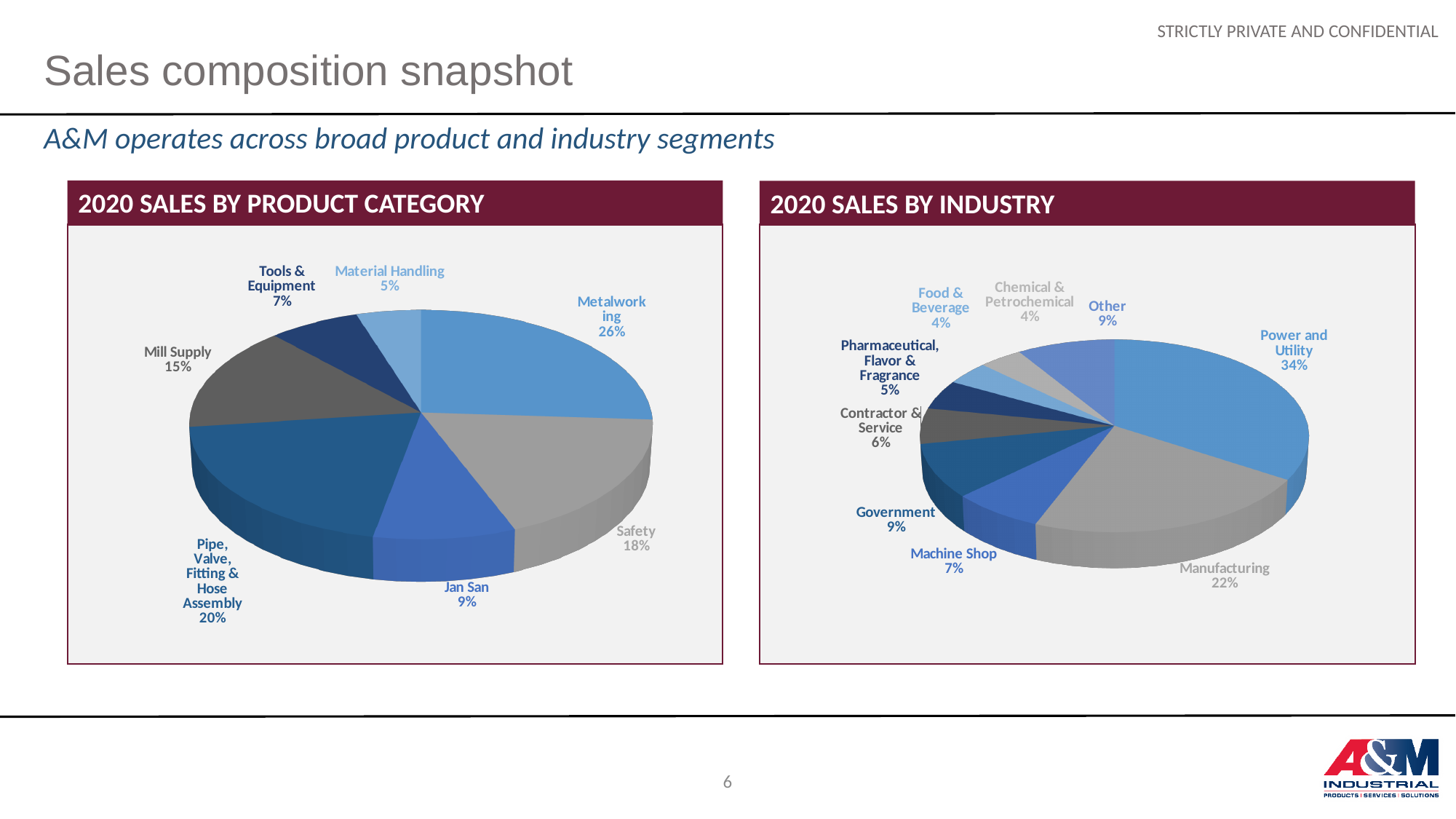
In the 2020 Sales by Industry chart, what is the difference between the Power and Utility and Manufacturing shares? 12 percentage points In the 2020 Sales by Industry chart, what share does Manufacturing have? 22% In the 2020 Sales by Product Category chart, what is the difference between the Safety and Jan San shares? 9 percentage points In the 2020 Sales by Product Category chart, which category has the largest share? Metalworking What type of chart is used for the 2020 Sales by Industry? Pie chart In the 2020 Sales by Product Category chart, how many product categories are shown? 7 In the 2020 Sales by Industry chart, how many industry segments are shown? 9 In the 2020 Sales by Product Category chart, what share does Pipe, Valve, Fitting & Hose Assembly have? 20% In the 2020 Sales by Industry chart, which is larger, Government or Machine Shop? Government In the 2020 Sales by Product Category chart, which category has the smallest share? Material Handling In the 2020 Sales by Industry chart, which industry has the largest share? Power and Utility In the 2020 Sales by Product Category chart, what share does Metalworking have? 26%